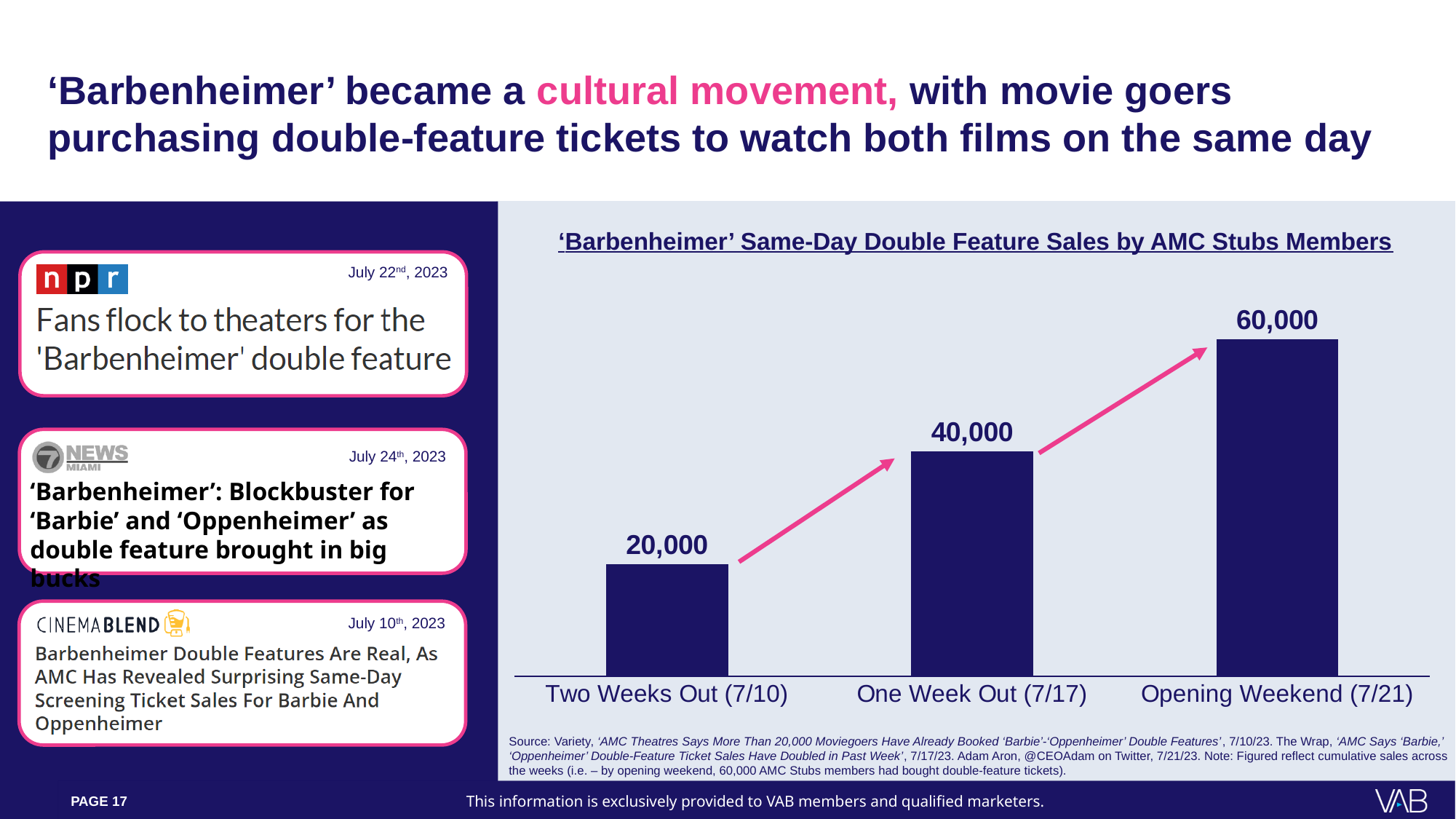
What is the value for One Week Out (7/17)? 40,000 What is the value for Opening Weekend (7/21)? 60,000 What is the value for Two Weeks Out (7/10)? 20,000 What is the difference between the values for One Week Out (7/17) and Two Weeks Out (7/10)? 20,000 What is the title of the chart? 'Barbenheimer' Same-Day Double Feature Sales by AMC Stubs Members Which is larger, the value for One Week Out (7/17) or the value for Opening Weekend (7/21)? Opening Weekend (7/21) What is the difference between the values for Opening Weekend (7/21) and Two Weeks Out (7/10)? 40,000 How many categories are shown on the x axis? 3 Which category has the highest value? Opening Weekend (7/21) Which category has the lowest value? Two Weeks Out (7/10) Do the values rise or fall from Two Weeks Out (7/10) to Opening Weekend (7/21)? Rise What kind of chart is shown on the slide? Bar chart